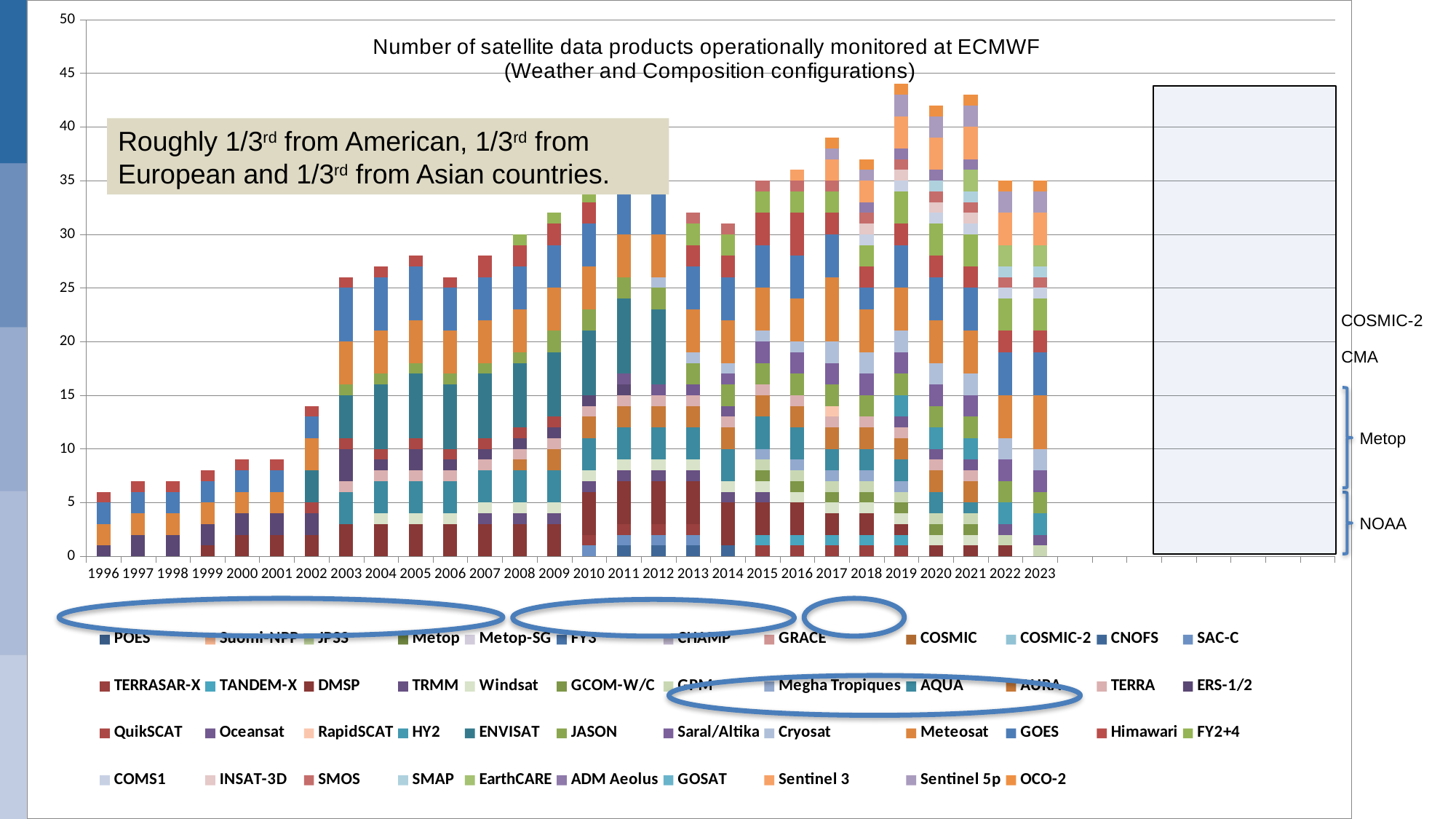
How many years are shown along the x axis of the chart? 28 Which year has the larger total of satellite data products, 2002 or 2003? 2003 Is the total number of satellite data products for 2019 greater or less than 40? greater Which year has the larger total of satellite data products, 2010 or 2019? 2019 Is the total number of satellite data products for 2023 greater or less than 40? less Is the total number of satellite data products for 1996 greater or less than 10? less What is the first year shown on the x axis? 1996 What kind of chart is shown on the slide? stacked bar chart Do the total bar heights generally rise or fall from 1996 to 2019? rise What is the last year shown on the x axis? 2023